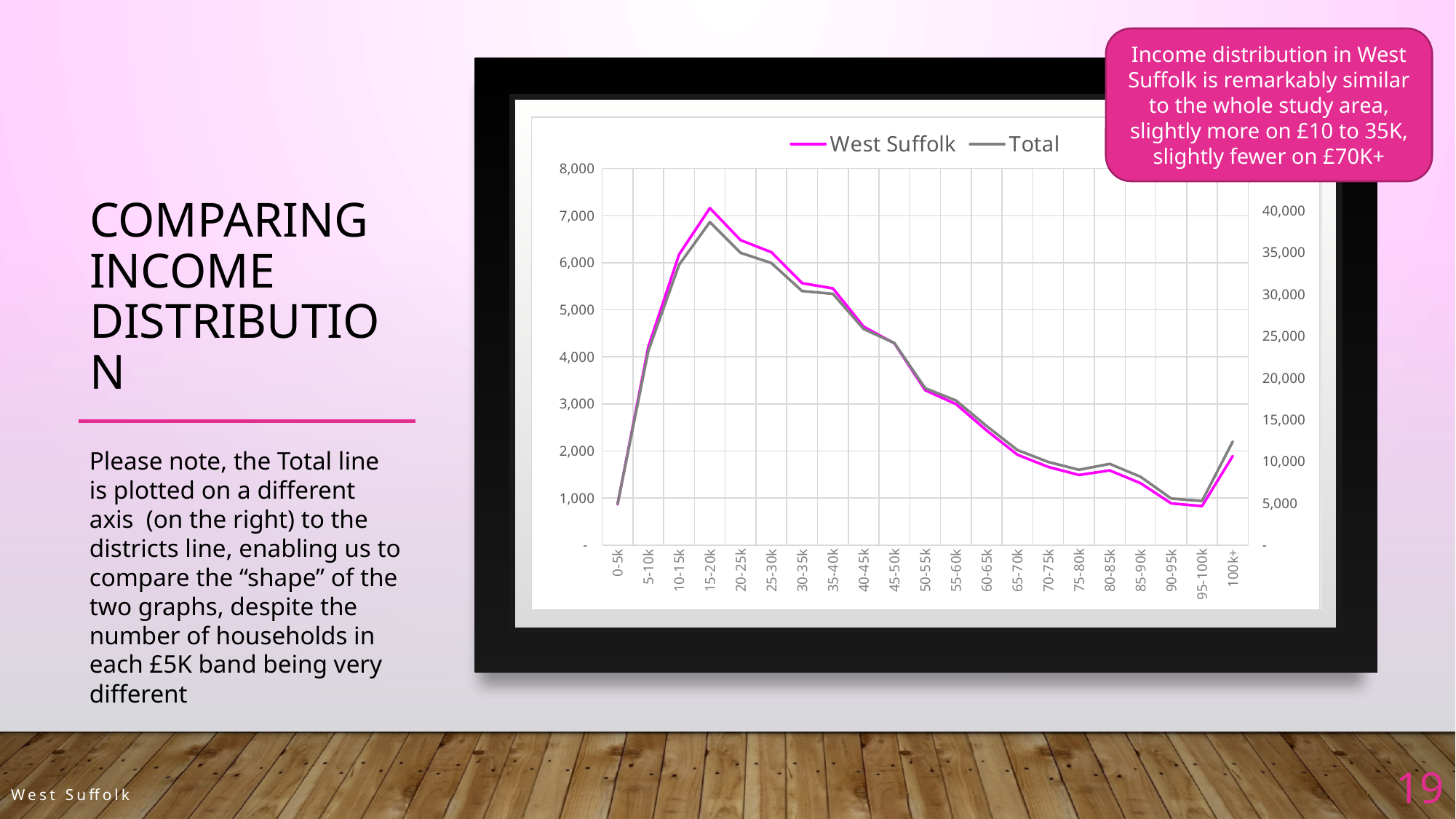
Which income band has the highest value for the Total series? 15-20k Do the West Suffolk values rise or fall along the x axis from the 15-20k band to the 95-100k band? Fall Is the Total value for the 15-20k band greater or less than 35,000 on the right-hand axis? greater Is the West Suffolk value for the 100k+ band greater or less than 1,000? greater How many series does the chart legend list? 2 Which income band has the highest value for the West Suffolk series? 15-20k How many income bands are shown along the x axis of the chart? 21 What colour is the West Suffolk line in the chart? Magenta (pink) For the West Suffolk series, which is larger: the value for 95-100k or the value for 100k+? 100k+ What kind of chart is shown on the slide? Line chart Is the West Suffolk value for the 0-5k band greater or less than 1,000? less